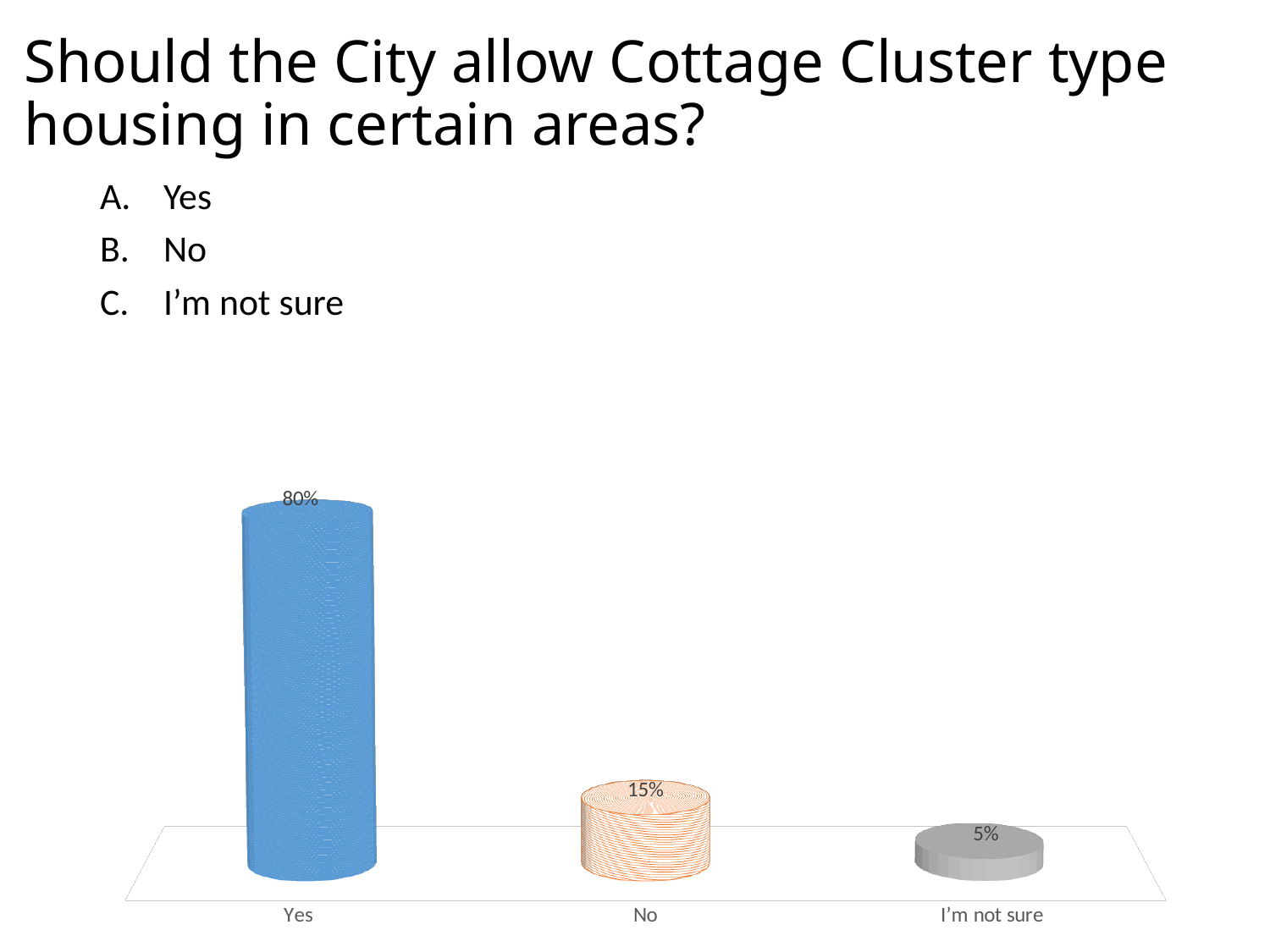
Which is larger, the value for "No" or the value for "I'm not sure"? No Which response category has the lowest value? I'm not sure What is the difference between the "No" and "I'm not sure" percentages? 10% What percentage of respondents answered "No"? 15% Do the values rise or fall from left to right across the categories? Fall How many response categories are shown in the chart? 3 What percentage of respondents answered "I'm not sure"? 5% What colour is the bar for "Yes"? Blue What kind of chart is shown on the slide? Bar chart What is the difference between the "Yes" and "No" percentages? 65% What percentage of respondents answered "Yes"? 80% Which response category has the highest value? Yes